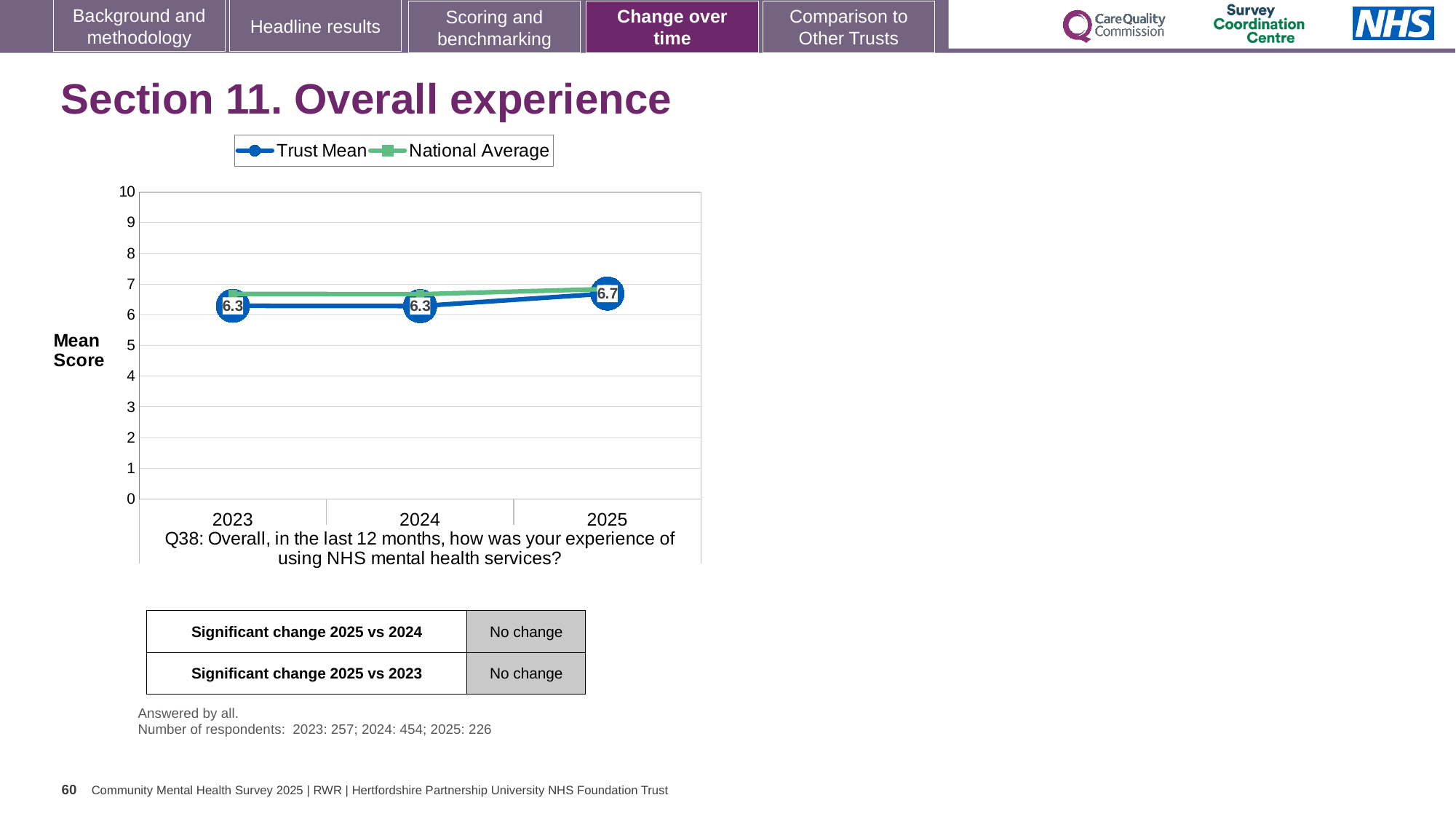
What is the Trust Mean value for 2025? 6.7 Which is larger, the Trust Mean for 2025 or for 2024? 2025 How many series does the legend list? 2 Is the National Average value for 2023 greater or less than 6? greater Is the National Average value for 2025 greater or less than 8? less What is the Trust Mean value for 2023? 6.3 In which year is the Trust Mean highest? 2025 What is the difference between the Trust Mean in 2025 and in 2023? 0.4 How many years are plotted on the x axis? 3 What is the label on the y axis of the chart? Mean Score What is the Trust Mean value for 2024? 6.3 What kind of chart is shown on the slide? Line chart